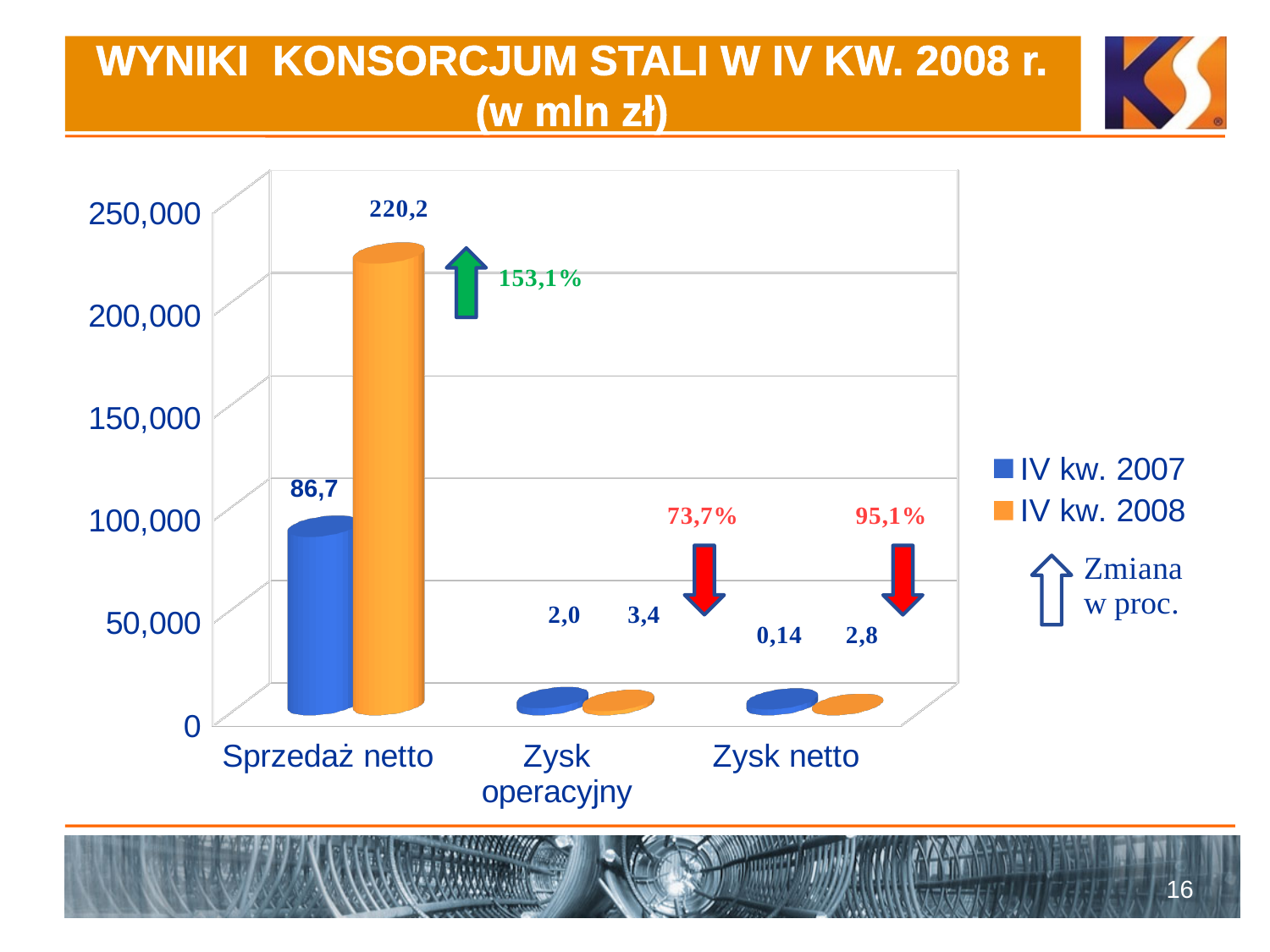
What is the value for Sprzedaż netto in the IV kw. 2007 series? 86,7 Which category has the lowest value in the IV kw. 2007 series? Zysk netto What percentage change is shown next to the Sprzedaż netto bars? 153,1% Is the IV kw. 2008 bar for Sprzedaż netto greater or less than 200,000 on the axis? greater What is the value for Sprzedaż netto in the IV kw. 2008 series? 220,2 How many categories are shown on the x axis? 3 How many series does the legend list? 2 What is the difference between the IV kw. 2008 and IV kw. 2007 values for Sprzedaż netto? 133,5 Which category has the highest value in the IV kw. 2008 series? Sprzedaż netto